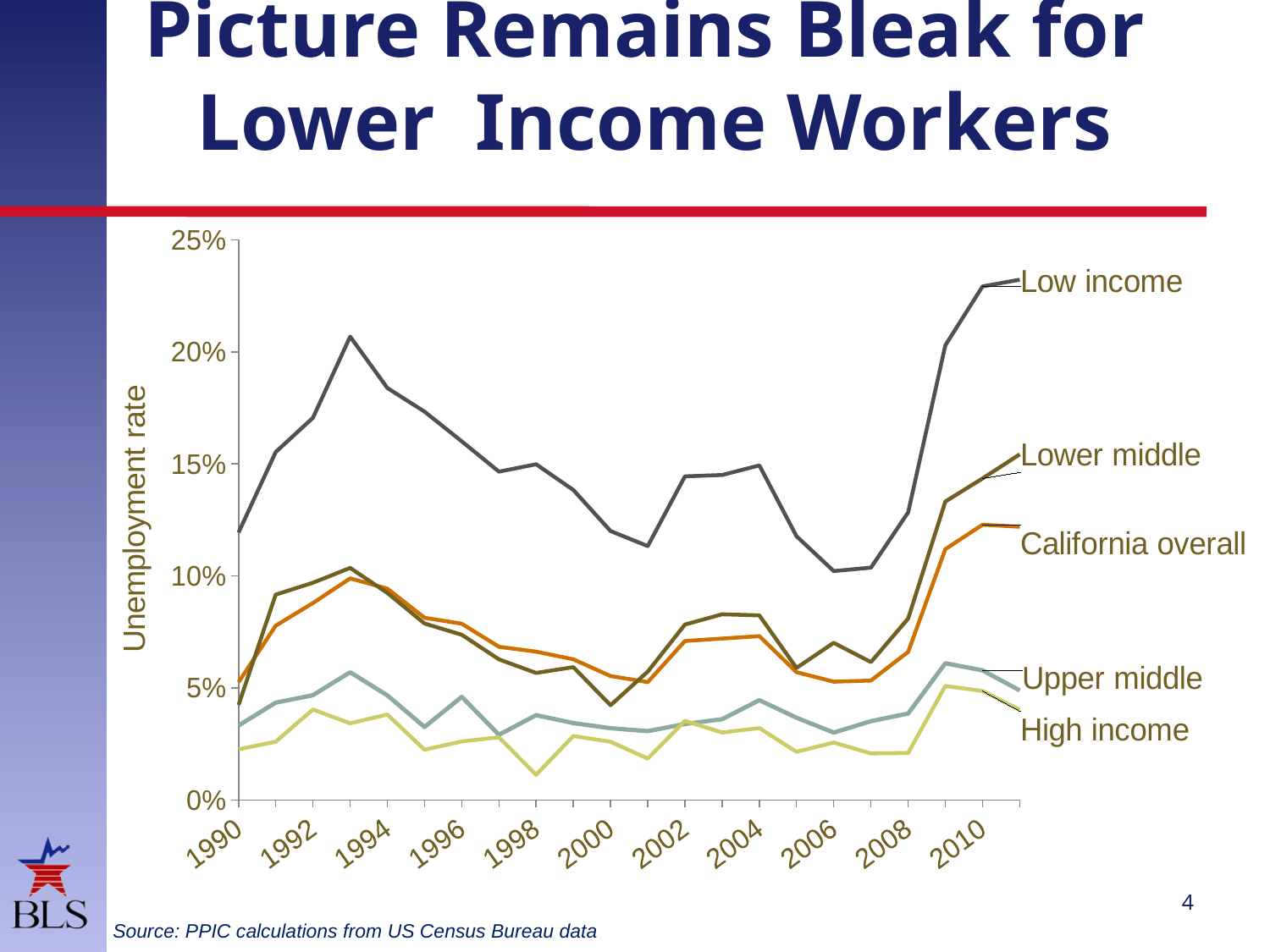
Is the unemployment rate for High income in 1998 greater or less than 5%? less In 1993, which series has the higher unemployment rate, Low income or Lower middle? Low income What is the label on the vertical axis of the chart? Unemployment rate What kind of chart is shown on the slide? line chart Is the unemployment rate for Low income in 1990 greater or less than 15%? less Does the Low income unemployment rate rise or fall between 2006 and 2010? rise Is the unemployment rate for Low income in 2010 greater or less than 20%? greater How many data series are labelled on the chart? 5 Which series has the lowest unemployment rate in 2010? High income What source is cited below the chart? PPIC calculations from US Census Bureau data Which series has the highest unemployment rate in 2010? Low income